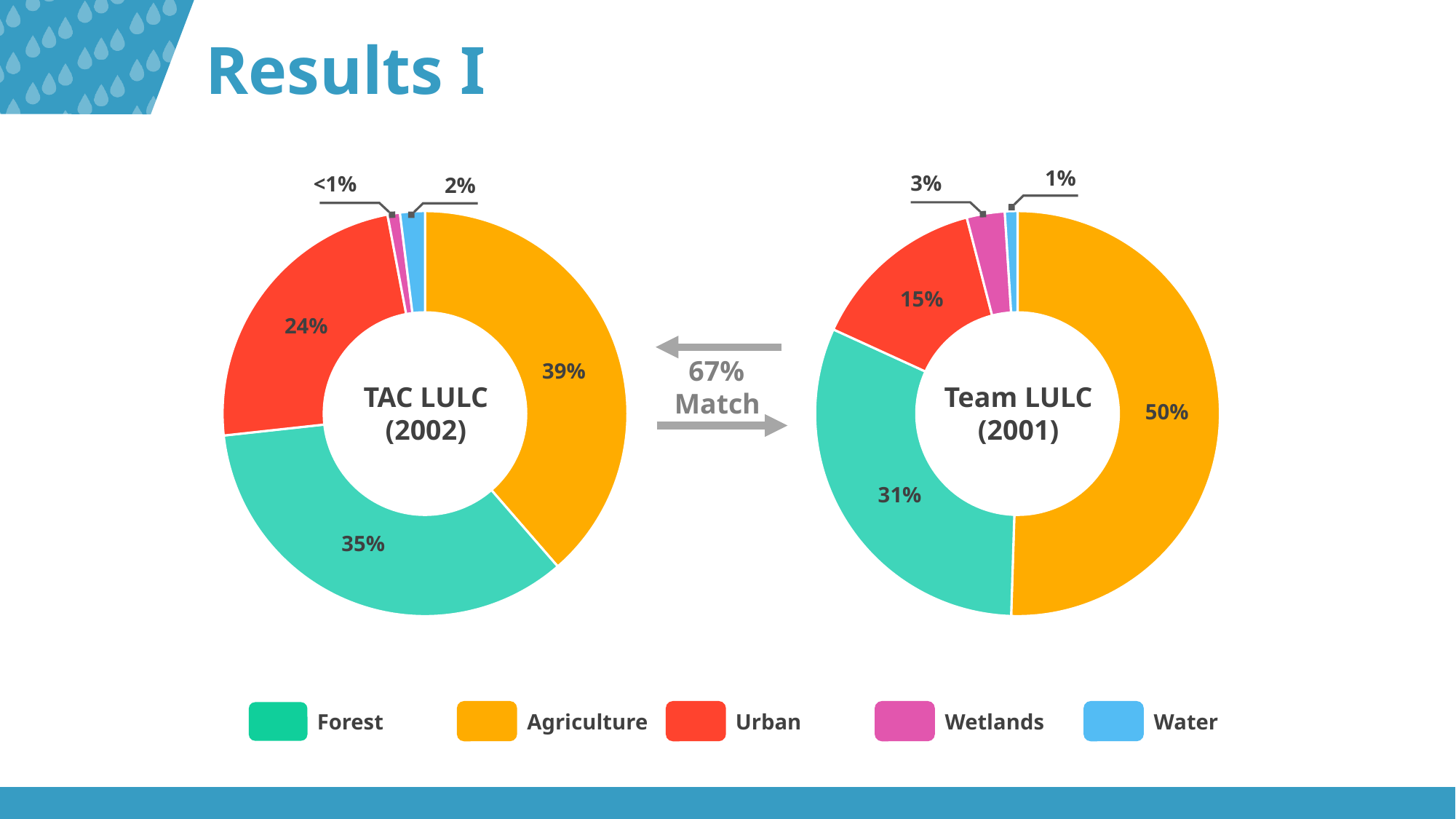
What match percentage is shown between the two charts? 67% In the TAC LULC (2002) chart, what share is Agriculture? 39% In the Team LULC (2001) chart, which category has the smallest share? Water In the TAC LULC (2002) chart, what share is Urban? 24% Which is larger: the Forest share in the TAC LULC (2002) chart or the Forest share in the Team LULC (2001) chart? TAC LULC (2002) What is the difference between the Urban share in the TAC LULC (2002) chart and the Urban share in the Team LULC (2001) chart? 9% In the Team LULC (2001) chart, what share is Wetlands? 3% In the Team LULC (2001) chart, what share is Forest? 31% How many categories does the legend list? 5 In the Team LULC (2001) chart, which category has the largest share? Agriculture In the TAC LULC (2002) chart, which category has the smallest share? Wetlands What kind of chart is the TAC LULC (2002) chart? Pie (donut) chart